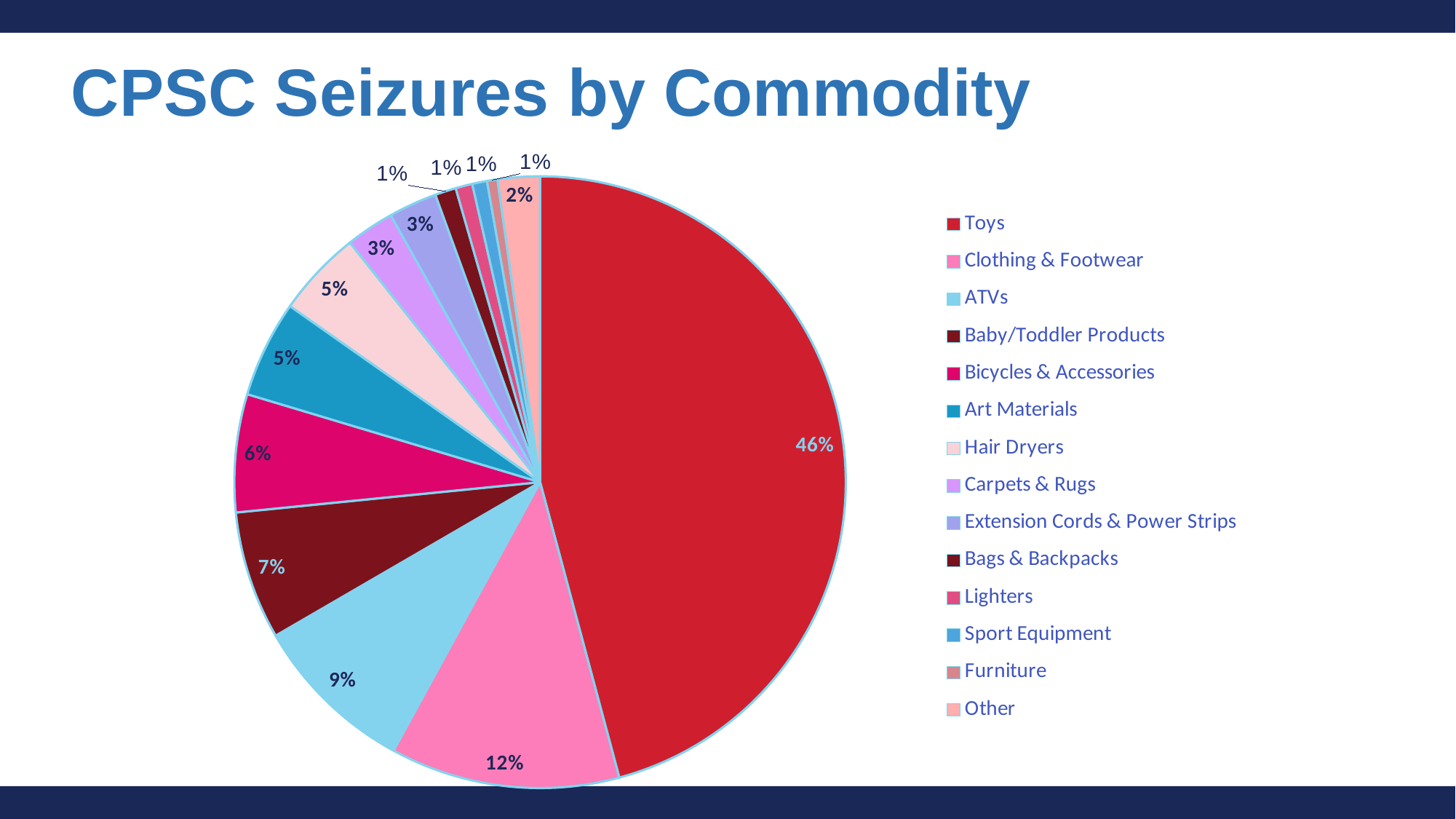
What share of CPSC seizures is ATVs? 9% Which commodity has the largest share of CPSC seizures? Toys What kind of chart is shown on the slide? pie chart What share of CPSC seizures is Bicycles & Accessories? 6% What share of CPSC seizures is Clothing & Footwear? 12% How many commodity categories are shown in the pie chart? 14 What is the title of the chart? CPSC Seizures by Commodity What is the difference in share between Toys and Clothing & Footwear? 34% Which has a larger share of seizures, ATVs or Baby/Toddler Products? ATVs